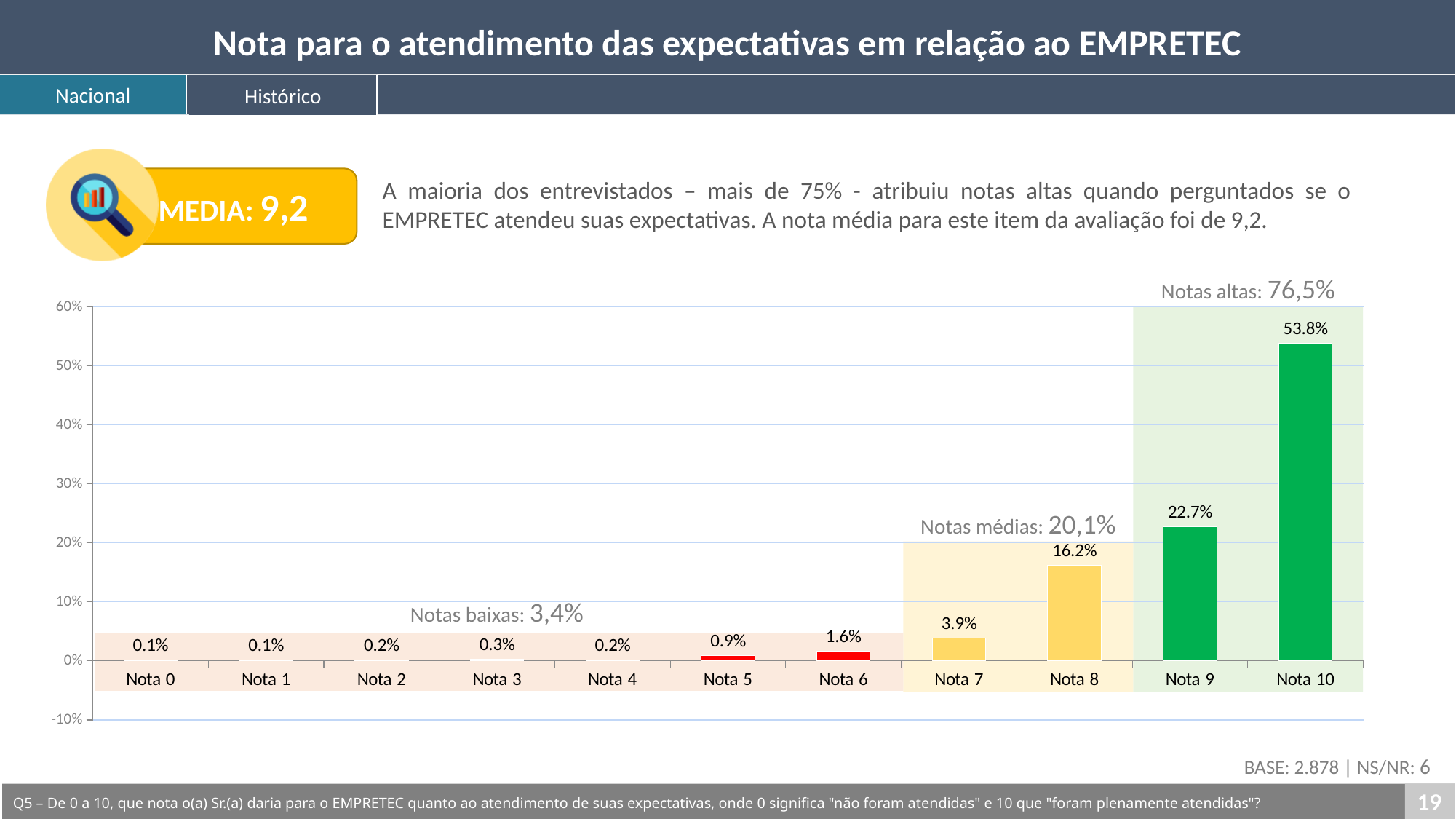
What percentage is shown for the 'Notas altas' group? 76,5% How many categories (notas) are shown on the x axis? 11 What is the value for Nota 8? 16.2% Is the value for Nota 10 greater or less than 50%? greater What is the value for Nota 6? 1.6% Which category has the highest value? Nota 10 What is the average score (MEDIA) shown on the slide? 9,2 What kind of chart is shown on the slide? bar chart What is the value for Nota 10? 53.8% Which is larger, the value for Nota 9 or the value for Nota 8? Nota 9 What is the difference between the values for Nota 8 and Nota 7? 12.3% What is the difference between the values for Nota 10 and Nota 9? 31.1%